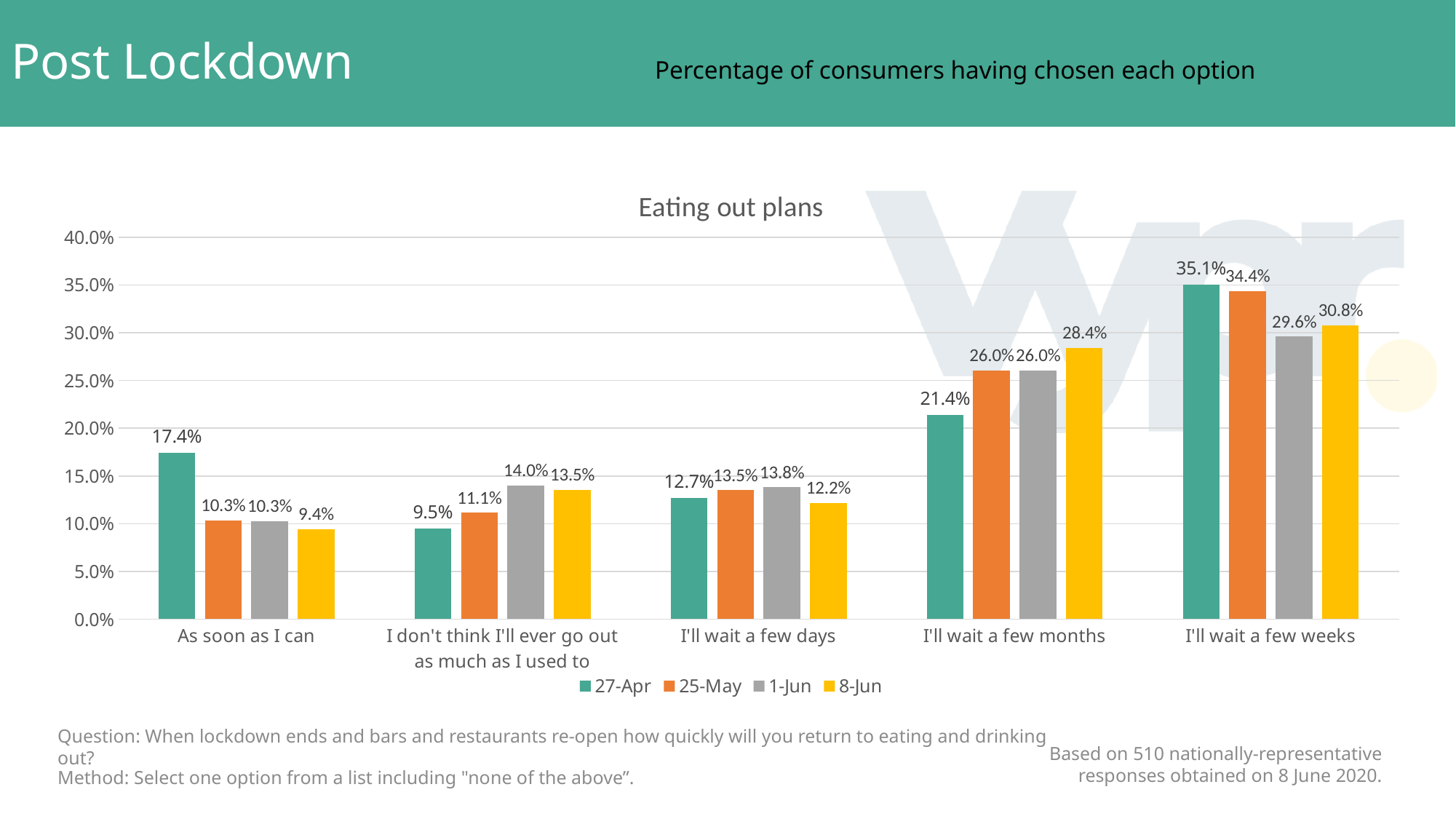
How many series does the legend list? 4 What kind of chart is shown on the slide? Bar chart What is the value for 'I'll wait a few weeks' in the 1-Jun series? 29.6% Is the 27-Apr value for 'I'll wait a few weeks' greater or less than 30.0%? greater Which category has the highest value in the 25-May series? I'll wait a few weeks What is the value for 'I'll wait a few months' in the 8-Jun series? 28.4% How many categories are shown on the x axis? 5 Which category has the lowest value in the 8-Jun series? As soon as I can Which is larger for 'I'll wait a few days': the 1-Jun value or the 8-Jun value? 1-Jun What is the difference between the 27-Apr and 8-Jun values for 'As soon as I can'? 8.0% What is the value for 'As soon as I can' in the 27-Apr series? 17.4% What is the title of the chart? Eating out plans